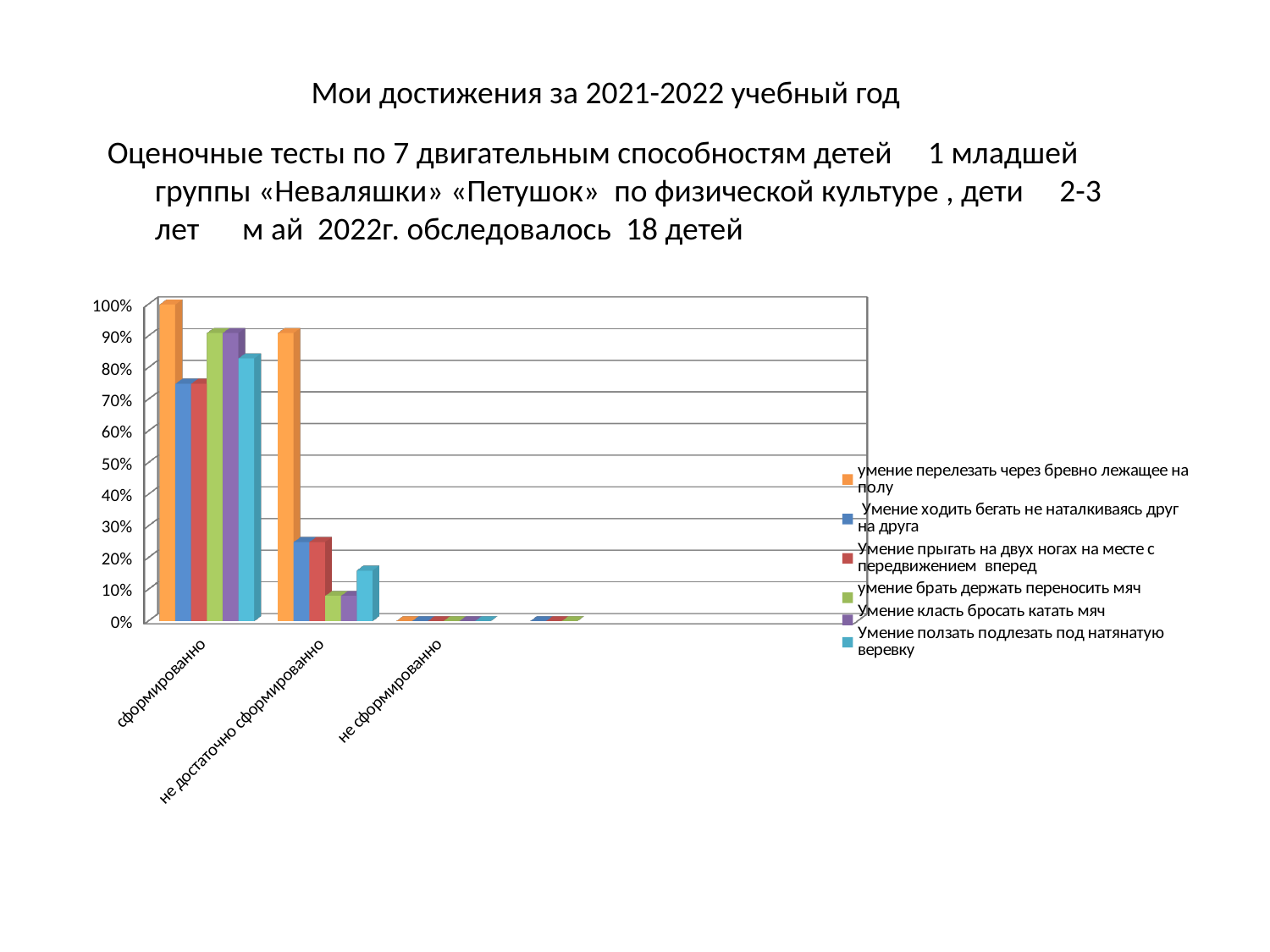
How many categories are shown on the x axis of the chart? 3 Is the value for "умение перелезать через бревно лежащее на полу" in the "сформированно" category greater or less than 90%? greater What kind of chart is shown on the slide? bar chart Is the value for "Умение ходить бегать не наталкиваясь друг на друга" in the "сформированно" category greater or less than 50%? greater In which category is the value for "Умение ходить бегать не наталкиваясь друг на друга" highest? сформированно Which series is listed first in the chart's legend? умение перелезать через бревно лежащее на полу How many series does the chart's legend list? 6 In the "сформированно" category, which is larger: "умение перелезать через бревно лежащее на полу" or "Умение ходить бегать не наталкиваясь друг на друга"? умение перелезать через бревно лежащее на полу Is the value for "Умение ползать подлезать под натянатую веревку" in the "не достаточно сформированно" category greater or less than 30%? less In the "не достаточно сформированно" category, which is larger: "умение перелезать через бревно лежащее на полу" or "умение брать держать переносить мяч"? умение перелезать через бревно лежащее на полу Do the values for "умение брать держать переносить мяч" rise or fall from "сформированно" to "не сформированно" along the x axis? fall